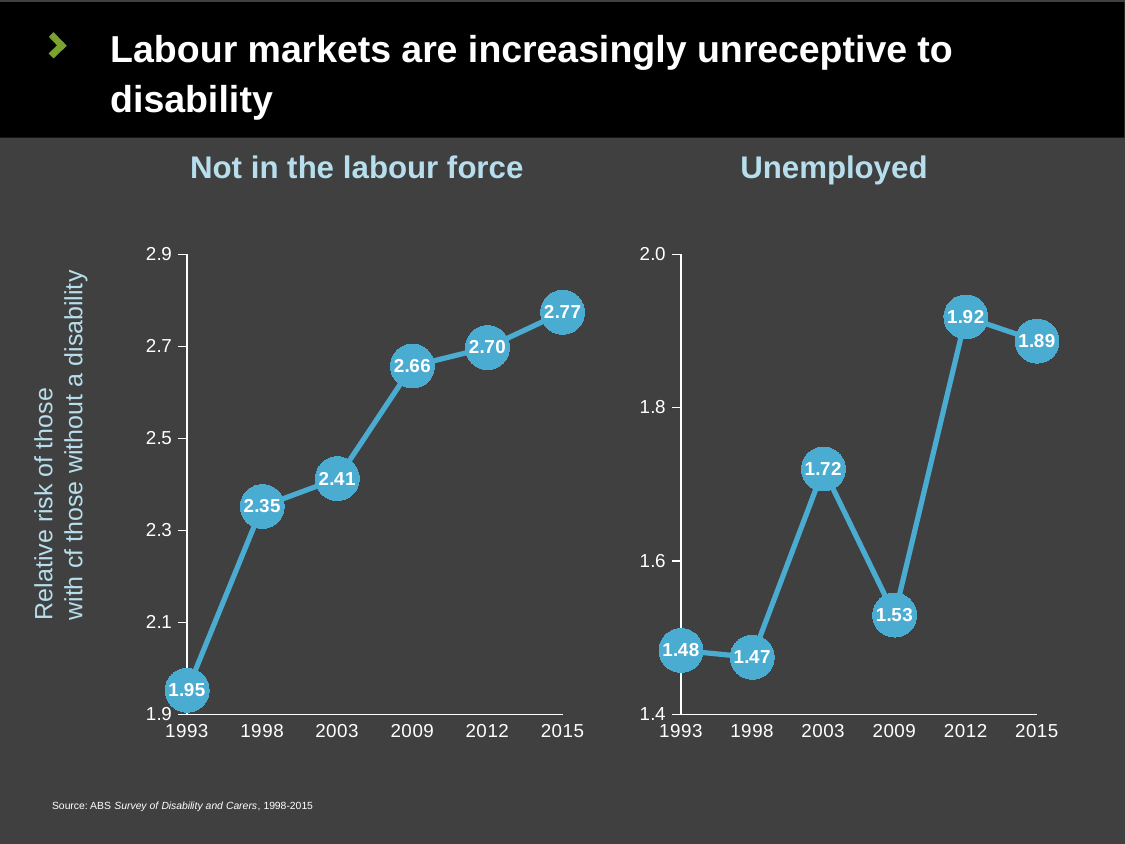
In the 'Unemployed' chart, which year has the lowest value? 1998 In the 'Not in the labour force' chart, what is the value for 2003? 2.41 In the 'Not in the labour force' chart, what is the difference between the 2015 and 1993 values? 0.82 In the 'Not in the labour force' chart, is the value for 1998 greater or less than 2.3? greater In the 'Not in the labour force' chart, which year has the highest value? 2015 In the 'Unemployed' chart, which year has the highest value? 2012 In the 'Unemployed' chart, what is the difference between the 2012 and 2009 values? 0.39 How many data points are plotted in the 'Not in the labour force' chart? 6 In the 'Not in the labour force' chart, do the values rise or fall from 1993 to 2015? Rise In the 'Unemployed' chart, which is larger, the value for 2003 or the value for 2015? 2015 What kind of chart is the 'Unemployed' chart? Line chart In the 'Unemployed' chart, what is the value for 2009? 1.53